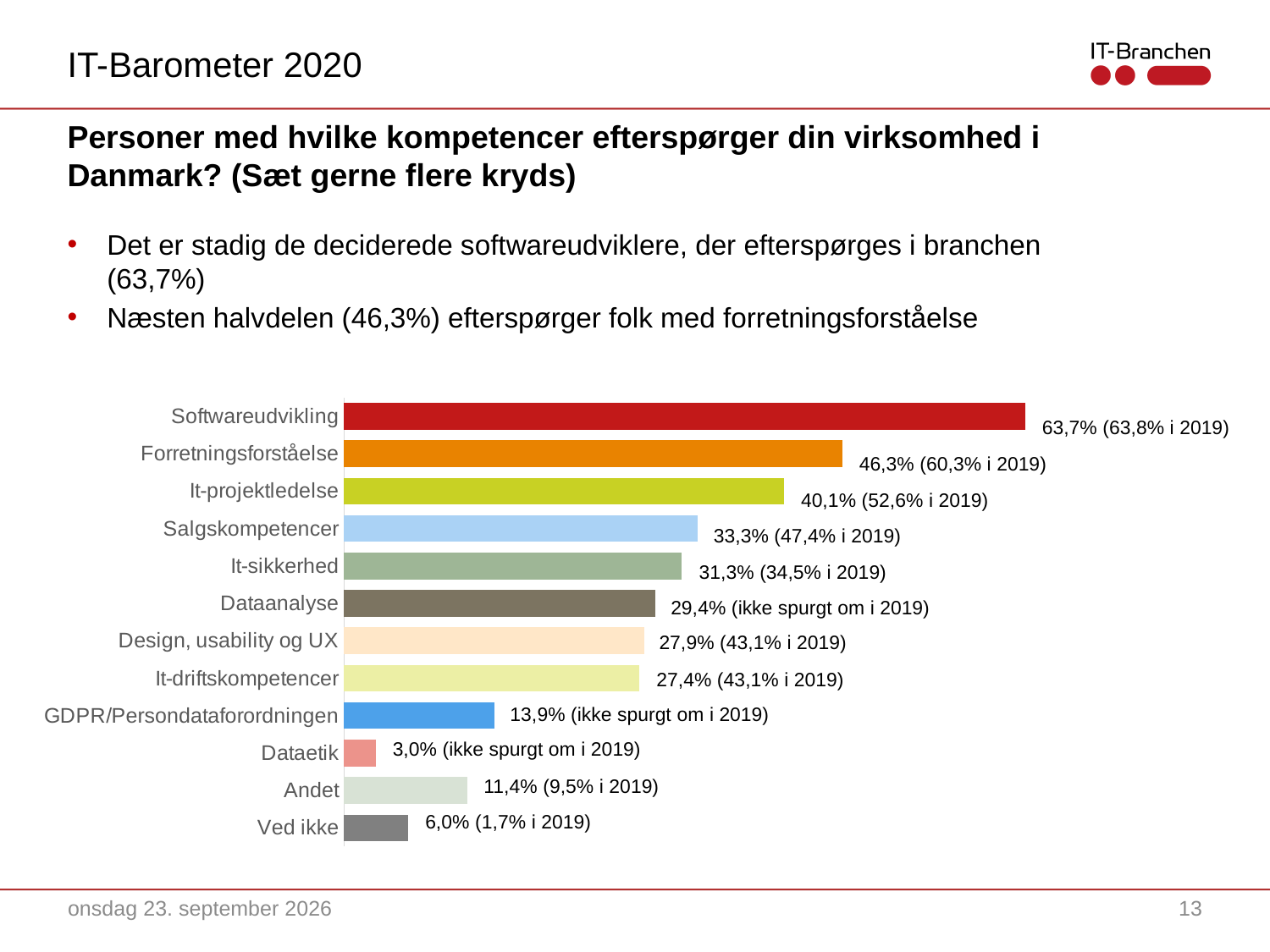
How many categories are shown in the chart? 12 Which has the larger 2020 value, Salgskompetencer or It-sikkerhed? Salgskompetencer Which category has the lowest 2020 value? Dataetik By how many percentage points did It-projektledelse fall from 2019 to 2020? 12,5 What is the difference in percentage points between the 2020 values for Softwareudvikling and Forretningsforståelse? 17,4 What was the 2019 value for Andet, as shown in the data label? 9,5% Which category has the highest 2020 value? Softwareudvikling What does the data label for Dataanalyse say about its 2019 value? ikke spurgt om i 2019 What is the 2020 value for It-sikkerhed? 31,3% What kind of chart is shown on the slide? Bar chart What was the 2019 value for It-projektledelse, as shown in the data label? 52,6% What is the 2020 value for Softwareudvikling? 63,7%